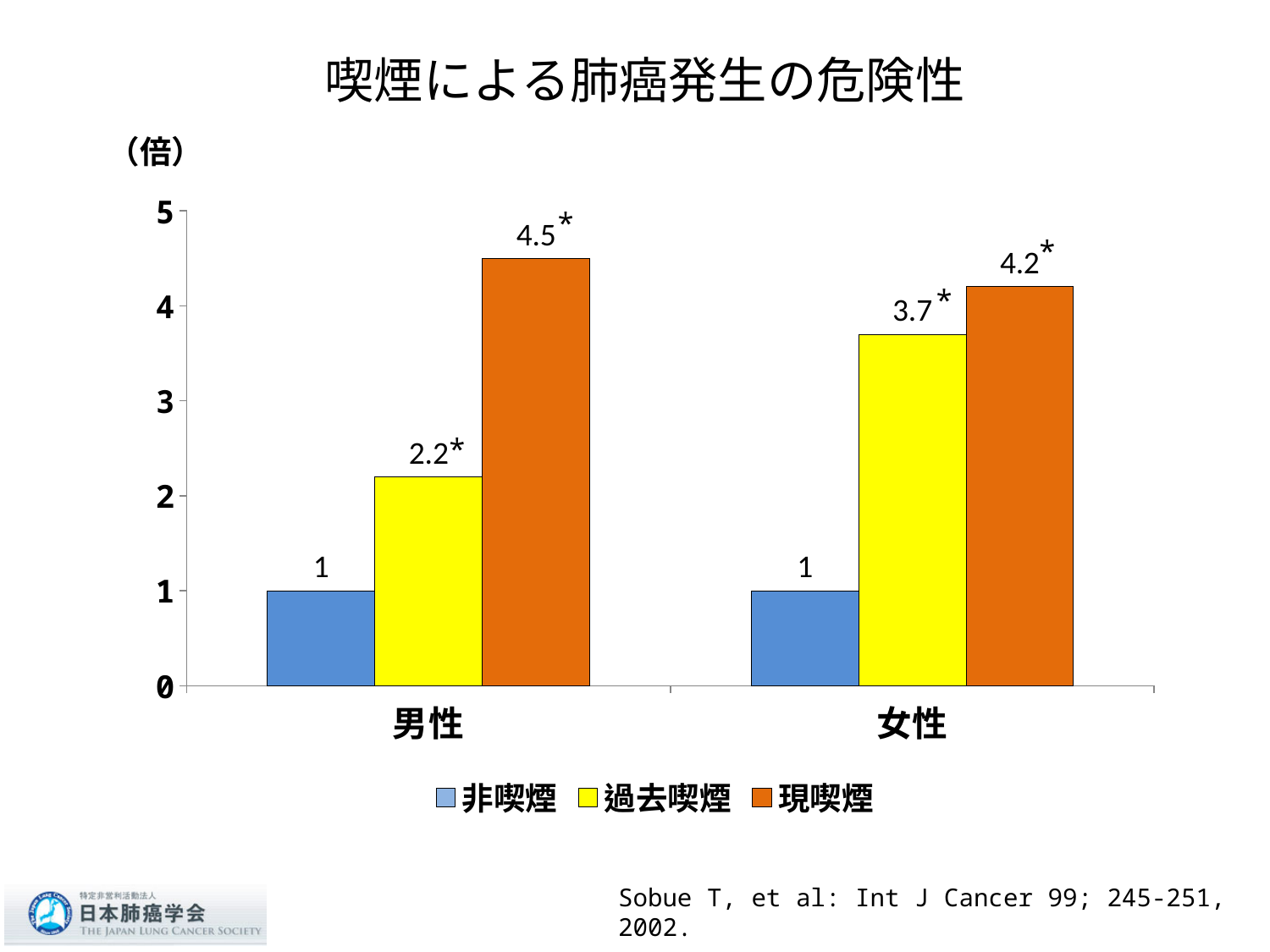
What is the title of the chart? 喫煙による肺癌発生の危険性 What is the value for 非喫煙 in the 男性 category? 1 What is the value for 過去喫煙 in the 女性 category? 3.7 What is the value for 現喫煙 in the 男性 category? 4.5 Which series has the lowest value in the 女性 category? 非喫煙 What is the difference between the 現喫煙 value and the 過去喫煙 value in the 男性 category? 2.3 Which series has the highest value in the 男性 category? 現喫煙 Which is larger: the 現喫煙 value for 男性 or the 現喫煙 value for 女性? 男性 How many series does the legend list? 3 How many categories are shown on the x axis? 2 What kind of chart is shown on the slide? bar chart What is the value for 現喫煙 in the 女性 category? 4.2